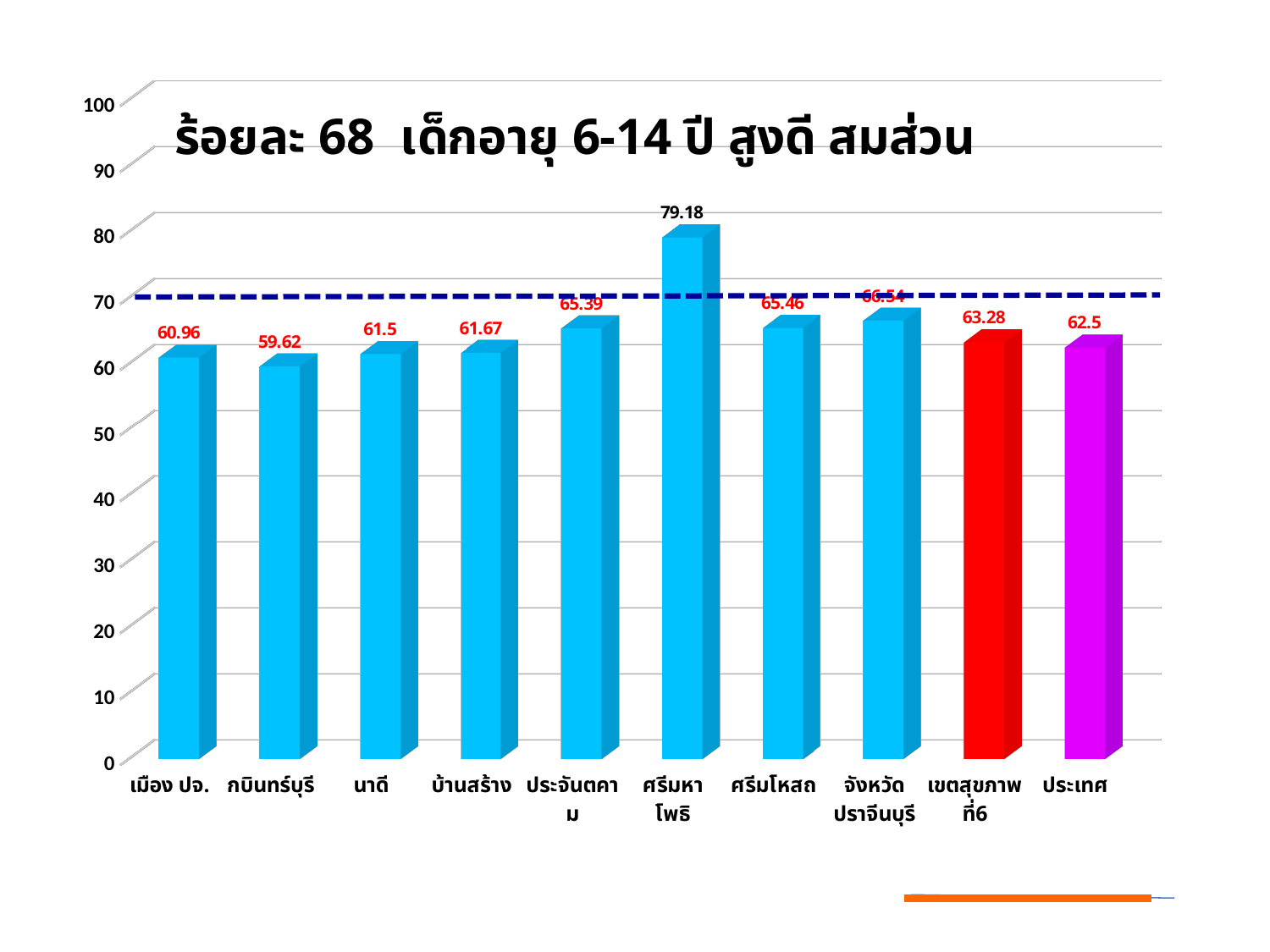
What colour is the bar for เขตสุขภาพที่6? red What kind of chart is shown on the slide? bar chart Is the value for ศรีมหาโพธิ greater or less than 70? greater What is the value for กบินทร์บุรี? 59.62 What is the value for เขตสุขภาพที่6? 63.28 Which category has the lowest value? กบินทร์บุรี How many categories are shown on the x axis? 10 What is the difference between the values for ศรีมหาโพธิ and กบินทร์บุรี? 19.56 Which is larger, the value for จังหวัดปราจีนบุรี or the value for ประเทศ? จังหวัดปราจีนบุรี What is the value for ประเทศ? 62.5 Which category has the highest value? ศรีมหาโพธิ What is the value for ศรีมหาโพธิ? 79.18